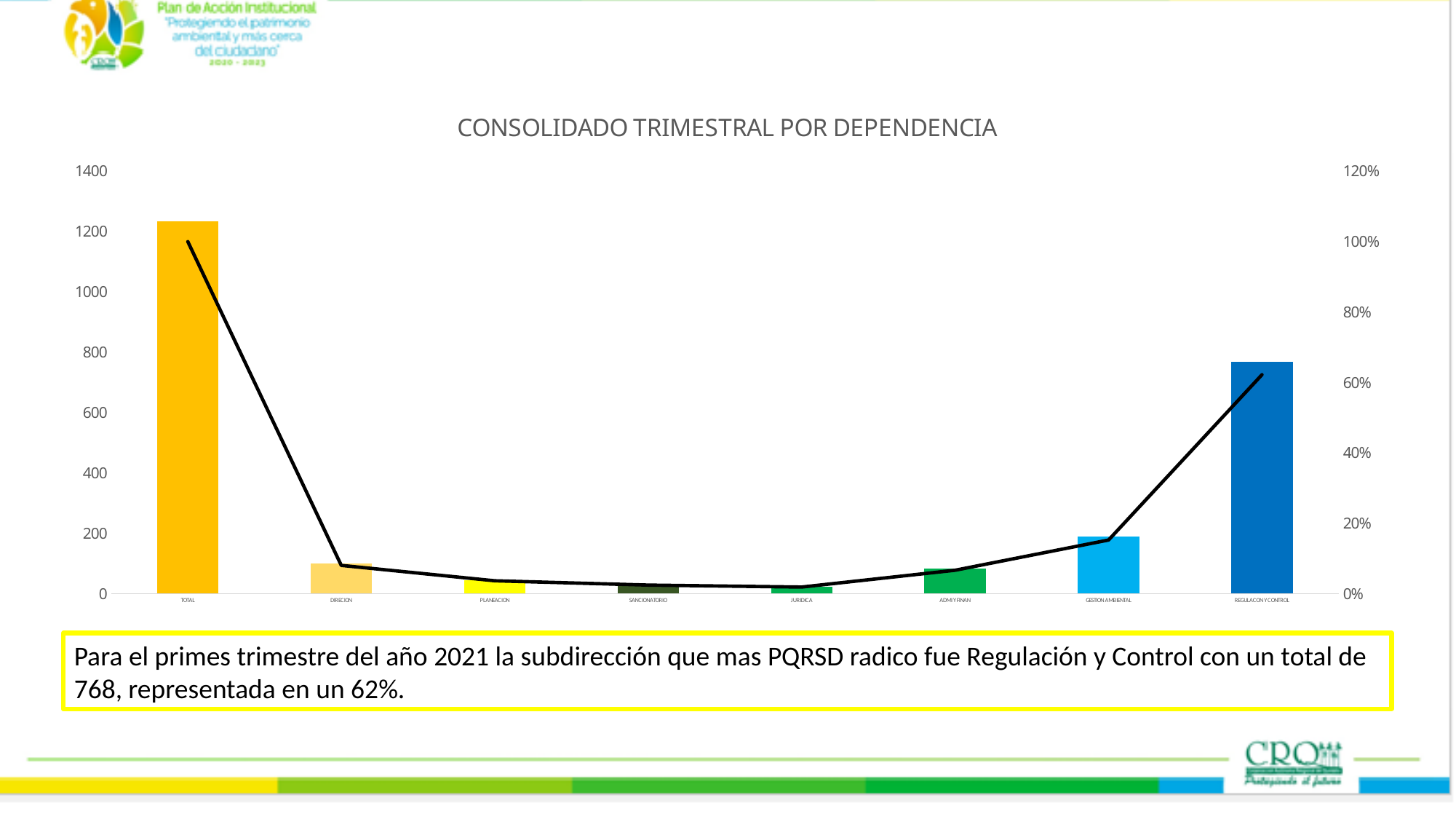
Excluding TOTAL, which dependency has the tallest bar? REGULACION Y CONTROL According to the slide, how many PQRSD did Regulación y Control register in the first quarter of 2021? 768 Which category has the tallest bar in the chart? TOTAL What kind of chart is shown on the slide? Bar chart with a line How many categories are shown along the x axis of the chart? 8 According to the slide, what percentage does Regulación y Control represent? 62% Which has the larger bar, GESTION AMBIENTAL or ADMI Y FINAN? GESTION AMBIENTAL What is the title of the chart? CONSOLIDADO TRIMESTRAL POR DEPENDENCIA Is the value for REGULACION Y CONTROL greater or less than 600? greater Is the value for TOTAL greater or less than 1000? greater Which has the larger bar, DIRECION or PLANEACION? DIRECION